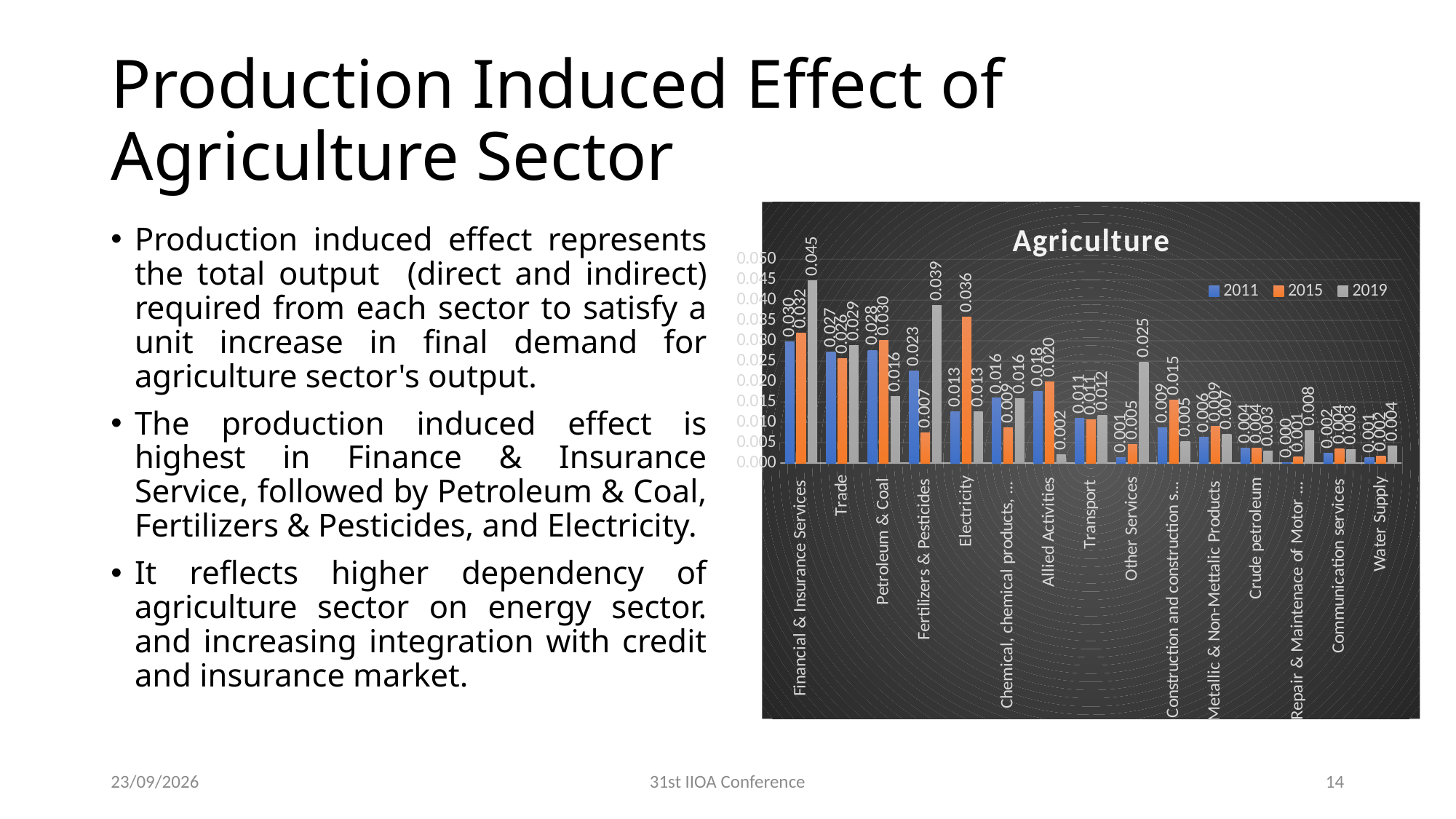
What is the 2019 value for Financial & Insurance Services in the Agriculture chart? 0.045 What kind of chart is shown on the slide? bar chart What is the title of the chart on the slide? Agriculture In the Agriculture chart, what is the difference between the 2019 and 2011 values for Financial & Insurance Services? 0.015 What is the 2019 value for Other Services in the Agriculture chart? 0.025 How many series does the legend of the Agriculture chart list? 3 In the Agriculture chart, which is larger for 2019: Fertilizers & Pesticides or Petroleum & Coal? Fertilizers & Pesticides What is the 2015 value for Electricity in the Agriculture chart? 0.036 How many sector categories are plotted along the x axis of the Agriculture chart? 15 What is the 2019 value for Fertilizers & Pesticides in the Agriculture chart? 0.039 Which sector has the highest 2015 value in the Agriculture chart? Electricity Which sector has the highest 2019 value in the Agriculture chart? Financial & Insurance Services